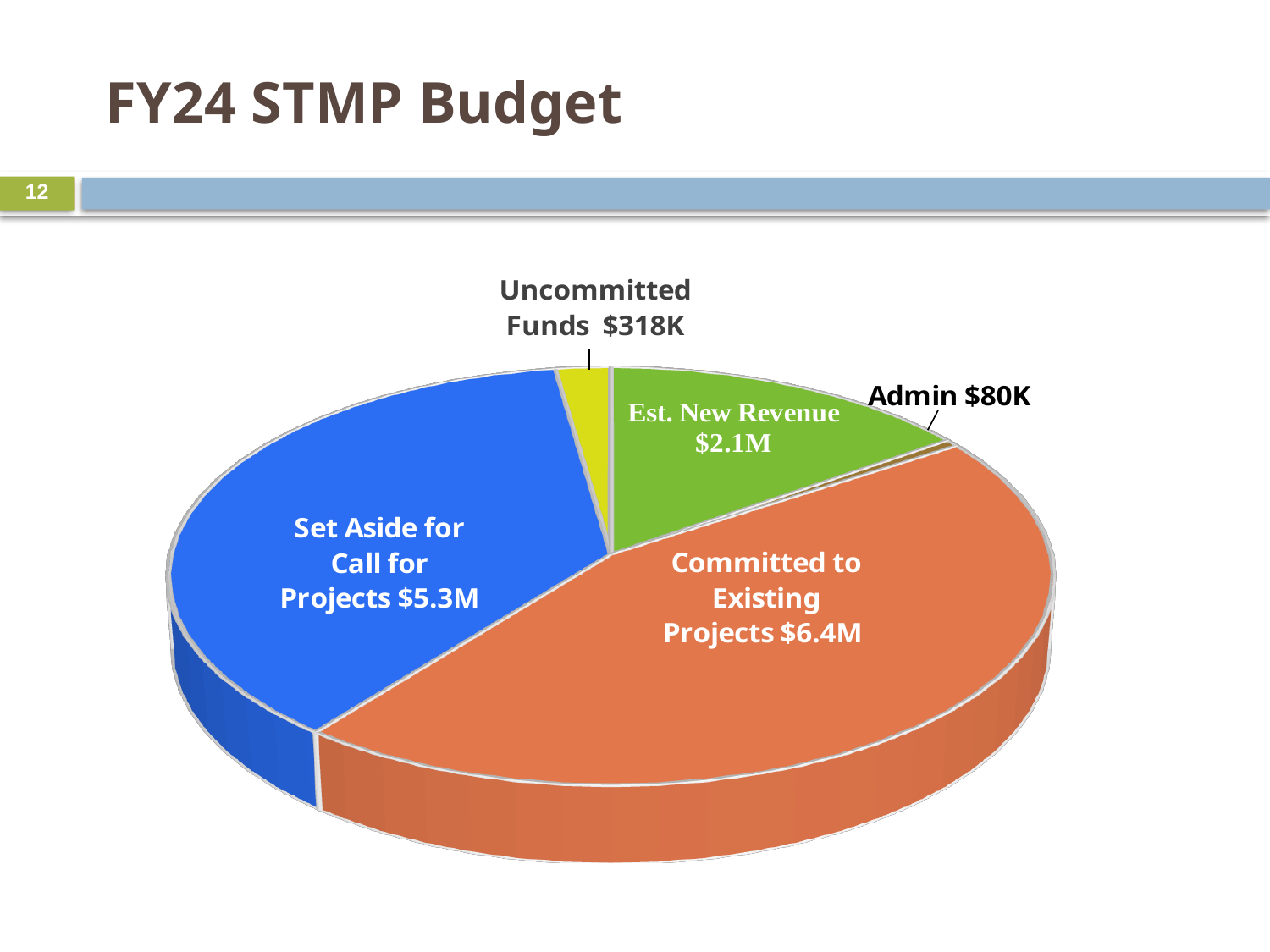
Which slice of the pie is the largest? Committed to Existing Projects What is the value of the Est. New Revenue slice? $2.1M What is the value of the Uncommitted Funds slice? $318K What is the value of the Set Aside for Call for Projects slice? $5.3M How many slices does the pie chart have? 5 What colour is the Set Aside for Call for Projects slice? Blue Which is larger, Est. New Revenue or Uncommitted Funds? Est. New Revenue Which slice of the pie is the smallest? Admin What is the value of the Admin slice? $80K What is the difference between Committed to Existing Projects and Set Aside for Call for Projects? $1.1M What kind of chart is shown on the slide? Pie chart What is the value of the Committed to Existing Projects slice? $6.4M